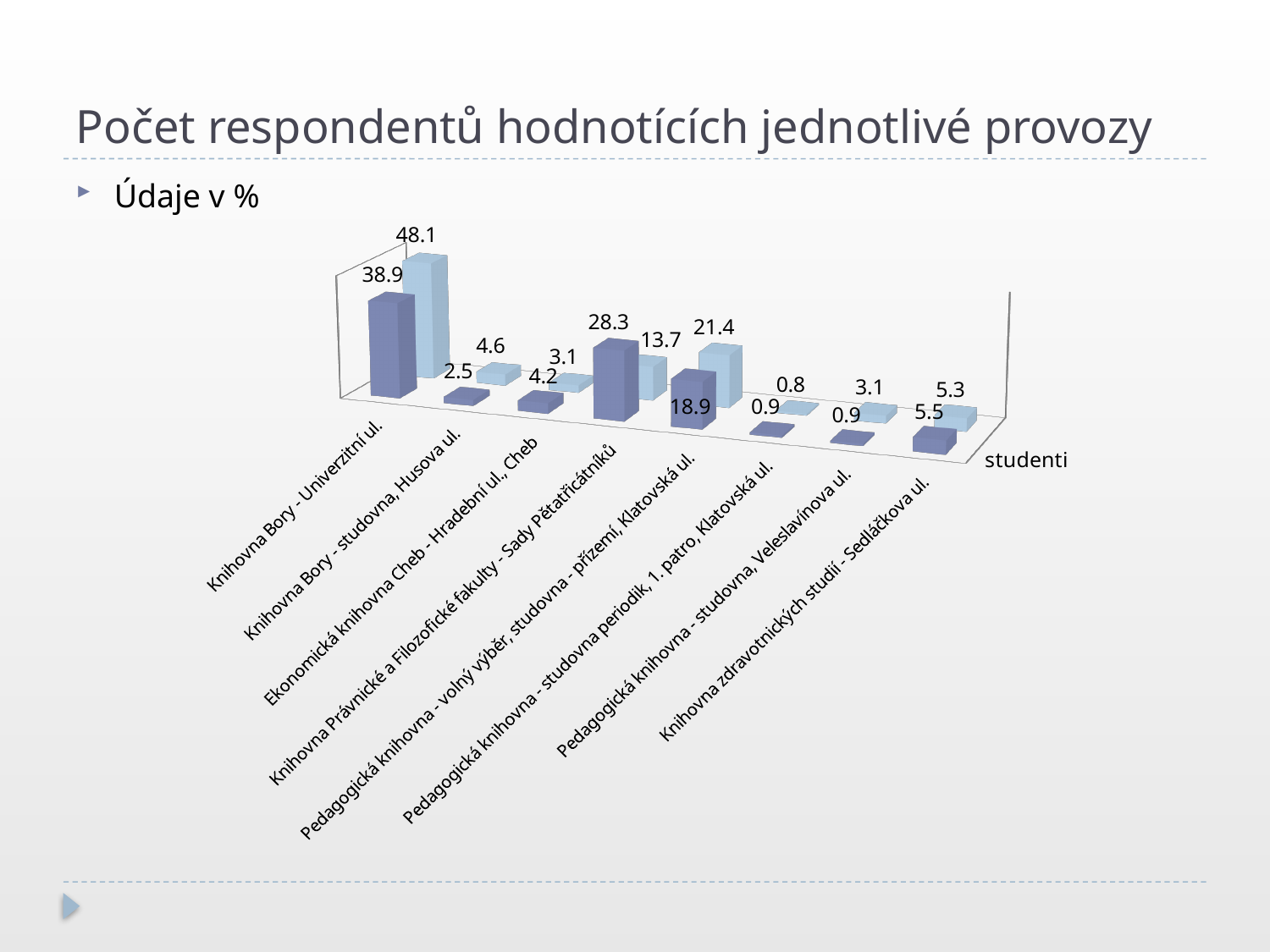
What is the value of the dark blue bar for Knihovna Právnické a Filozofické fakulty - Sady Pětatřicátníků? 28.3 What is the value of the studenti series for Knihovna Bory - Univerzitní ul.? 38.9 How many categories (library locations) are shown on the chart? 8 Which category has the highest value in the studenti series? Knihovna Bory - Univerzitní ul. What kind of chart is shown on the slide? bar chart In the studenti series, what is the difference between Pedagogická knihovna - volný výběr, studovna - přízemí, Klatovská ul. and Knihovna Právnické a Filozofické fakulty - Sady Pětatřicátníků? 9.4 What is the value of the studenti series for Pedagogická knihovna - volný výběr, studovna - přízemí, Klatovská ul.? 18.9 In what unit are the chart values given, according to the slide? % What is the title of the slide containing the chart? Počet respondentů hodnotících jednotlivé provozy Which category has the lowest value in the studenti series? Pedagogická knihovna - studovna periodik, 1. patro, Klatovská ul. and Pedagogická knihovna - studovna, Veleslavínova ul. (both 0.9)